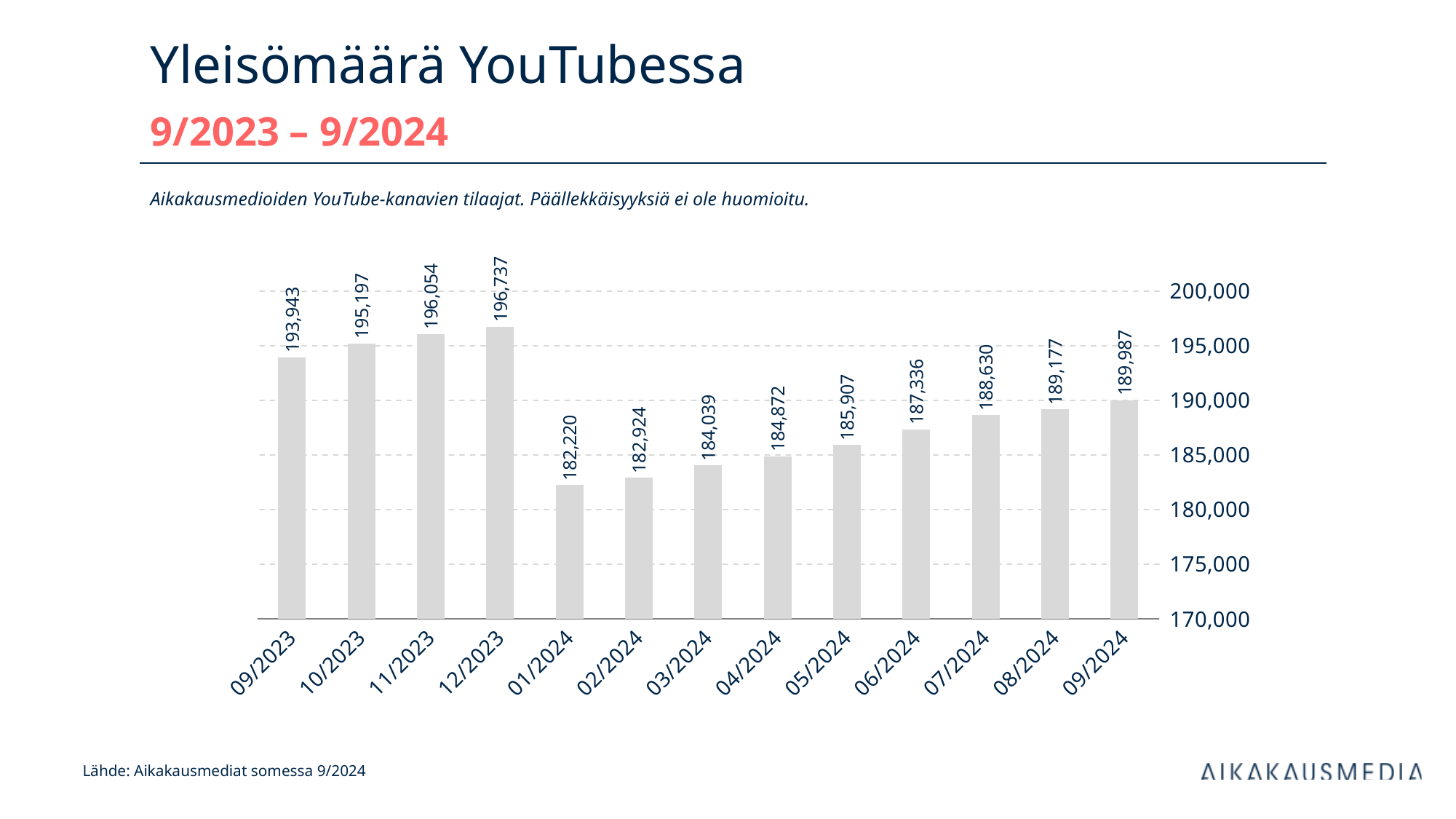
What kind of chart is shown on the slide? bar chart What is the value for 01/2024? 182,220 Which month has the lowest value? 01/2024 What is the difference between the values for 12/2023 and 01/2024? 14,517 How many months are shown on the x axis? 13 Do the values rise or fall from 01/2024 to 09/2024? rise What is the value for 09/2024? 189,987 What is the title of the chart? Yleisömäärä YouTubessa What is the value for 12/2023? 196,737 Which month has the highest value? 12/2023 Which is larger, the value for 09/2023 or the value for 09/2024? 09/2023 Is the value for 05/2024 greater or less than 190,000? less